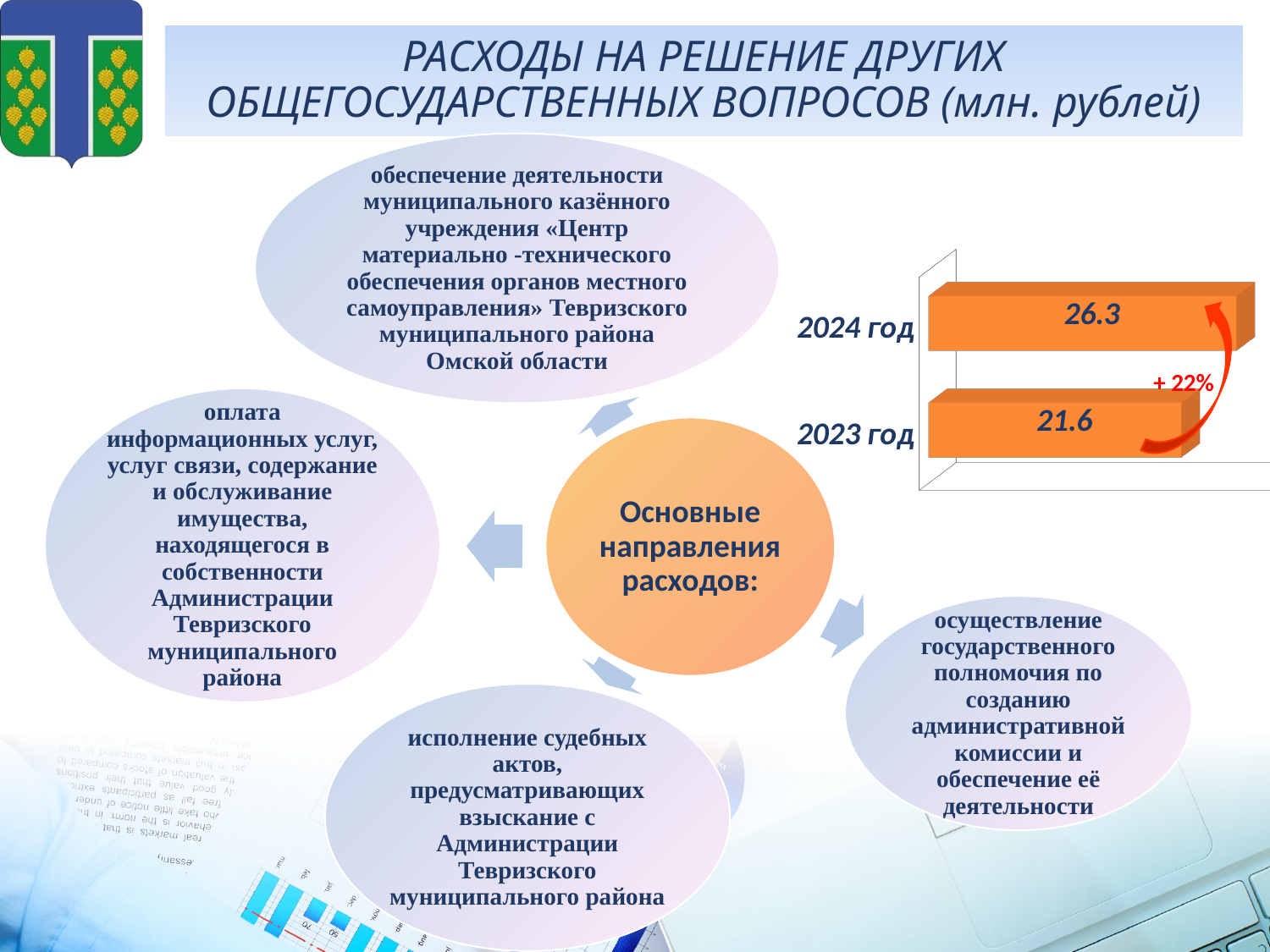
Which year has the lowest value? 2023 год In what units are the chart values expressed, according to the slide title? млн. рублей What percentage change is annotated on the chart between 2023 год and 2024 год? + 22% What is the value for 2023 год? 21.6 Which year has the highest value? 2024 год Do the values rise or fall from 2023 год to 2024 год? Rise What is the difference between the values for 2024 год and 2023 год? 4.7 What kind of chart is shown on the slide? Bar chart How many bars are shown in the chart? 2 What is the value for 2024 год? 26.3 Which is larger, the value for 2023 год or the value for 2024 год? 2024 год